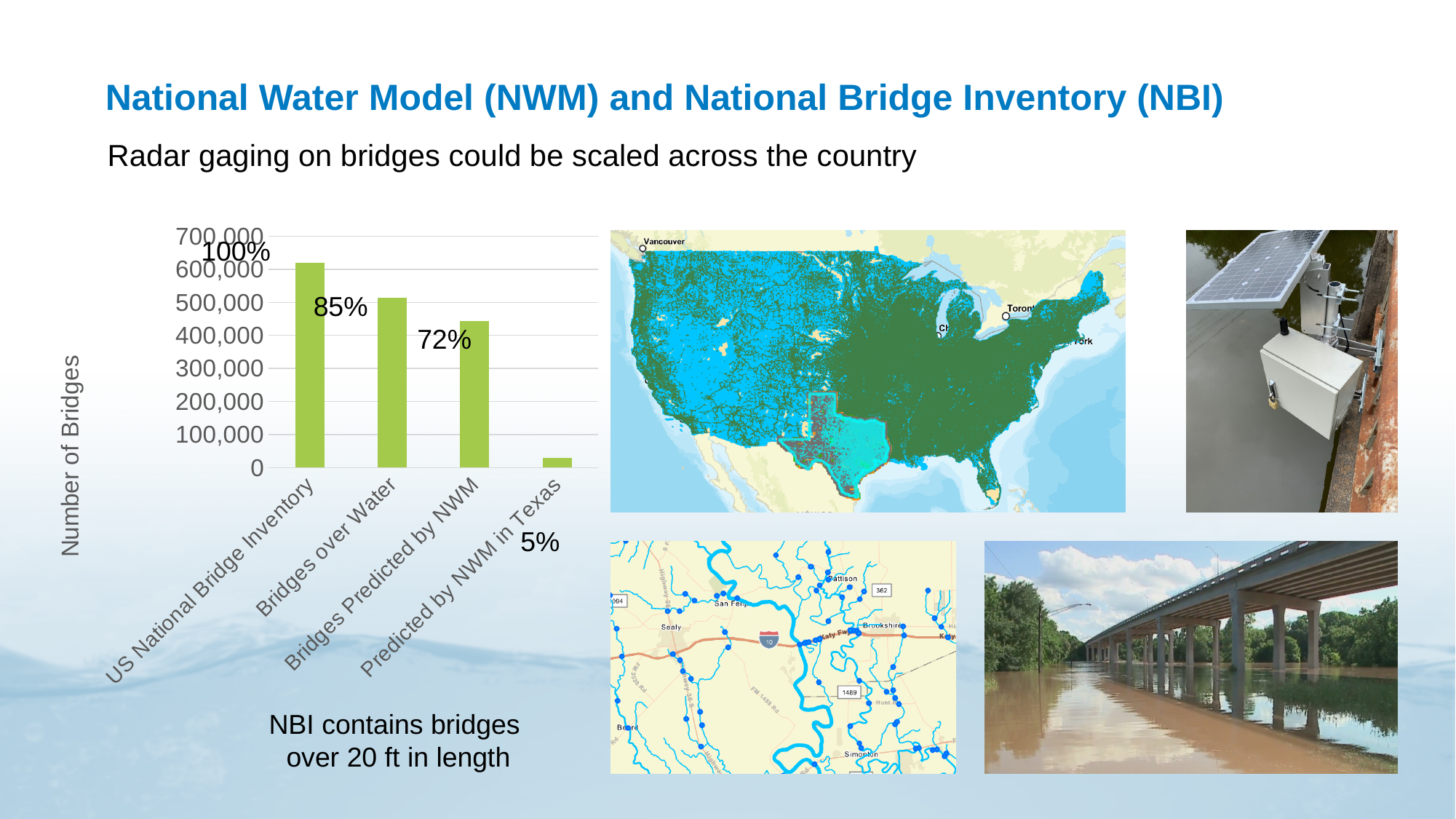
What percentage label is shown for Bridges over Water? 85% Is the value for Bridges Predicted by NWM greater or less than 500,000? less What percentage label is shown for Predicted by NWM in Texas? 5% Is the value for US National Bridge Inventory greater or less than 500,000? greater Is the value for Predicted by NWM in Texas greater or less than 100,000? less How many categories are plotted in the bar chart? 4 Which category has the lowest number of bridges? Predicted by NWM in Texas What percentage label is shown for Bridges Predicted by NWM? 72% What kind of chart is shown on the slide? bar chart What is the label on the vertical axis of the chart? Number of Bridges Which category has the highest number of bridges? US National Bridge Inventory Which is larger, the value for Bridges over Water or the value for Bridges Predicted by NWM? Bridges over Water